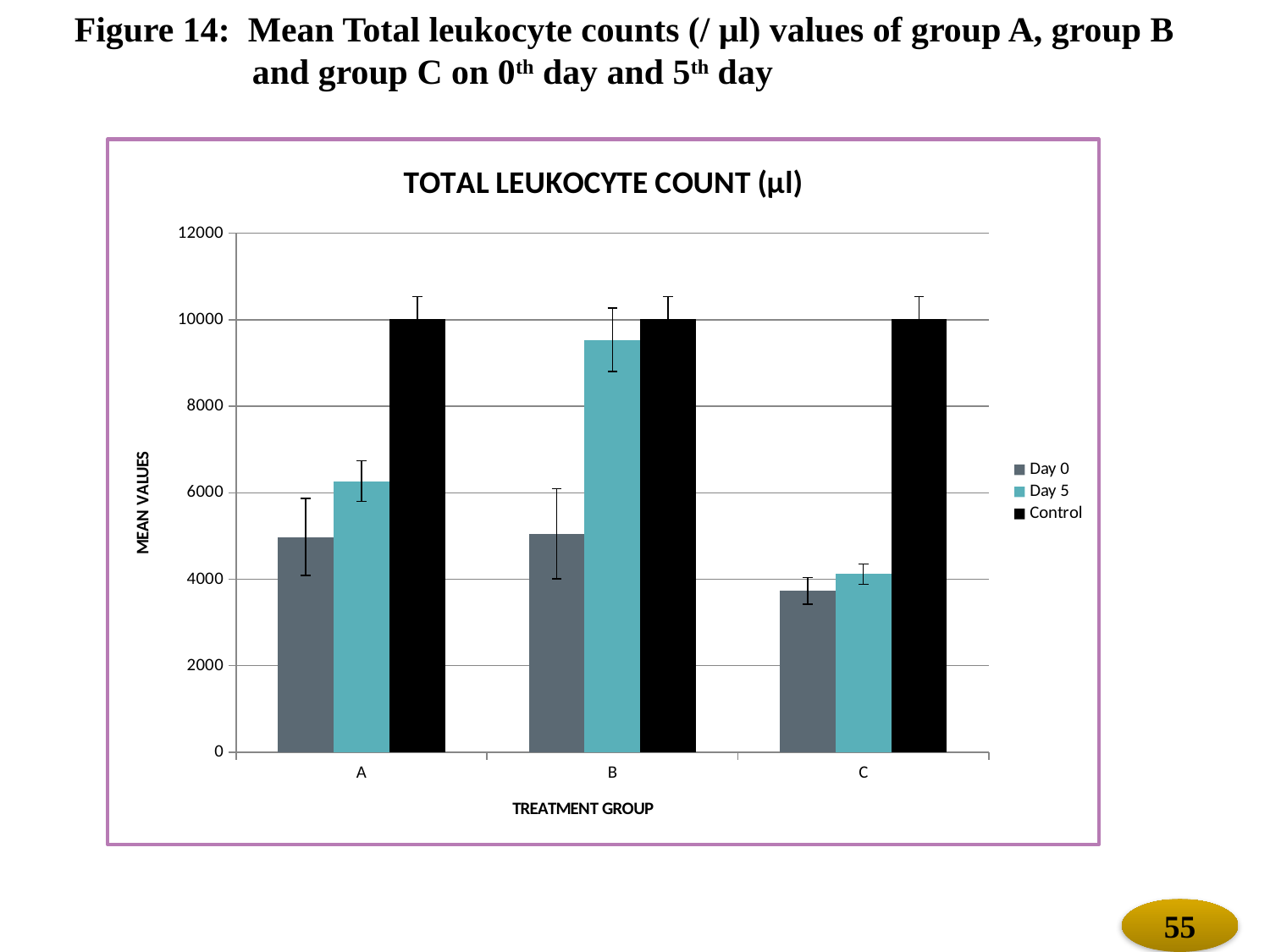
Is the Day 5 value for group B greater or less than 8000? greater Is the Day 0 value for group A greater or less than 4000? greater How many series does the legend list? 3 In group B, which is larger: the Day 0 value or the Day 5 value? Day 5 What is the title of the chart? TOTAL LEUKOCYTE COUNT (µl) Which treatment group has the highest Day 5 value? B Is the Day 5 value for group C greater or less than 6000? less Which treatment group has the lowest Day 0 value? C What kind of chart is shown on the slide? bar chart How many treatment groups are shown on the x axis? 3